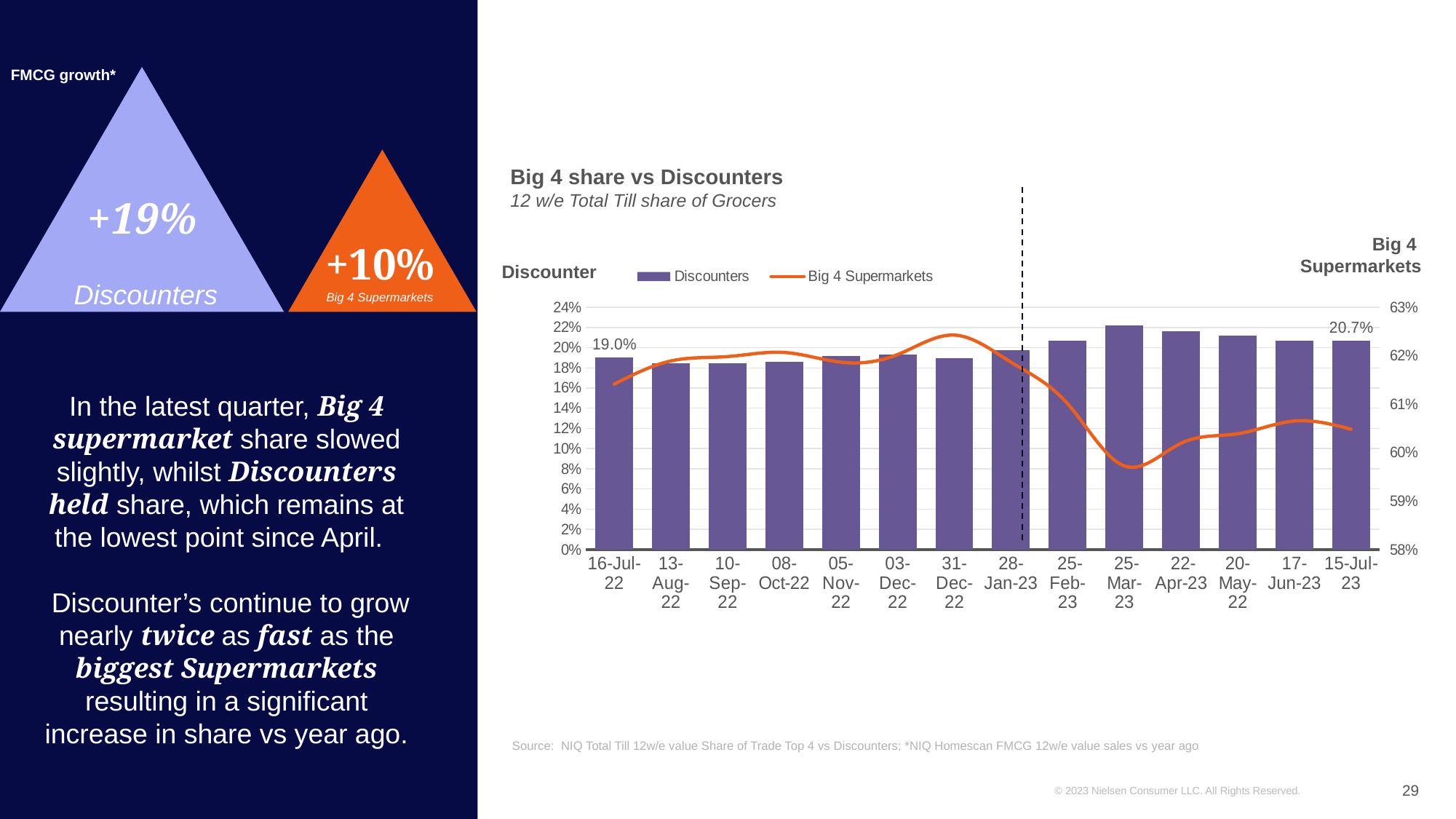
Does the Big 4 Supermarkets line rise or fall between 28-Jan-23 and 25-Mar-23? Fall Which is larger, the Discounters value for 16-Jul-22 or for 15-Jul-23? 15-Jul-23 Is the Big 4 Supermarkets value for 31-Dec-22 greater or less than 62%? greater What is the Discounters value for 16-Jul-22? 19.0% Which period has the highest Discounters bar? 25-Mar-23 What is the Discounters value for 15-Jul-23? 20.7% How many time periods are shown on the x axis? 14 Which series is plotted as a line? Big 4 Supermarkets What is the difference between the Discounters values for 15-Jul-23 and 16-Jul-22? 1.7 percentage points Is the Discounters value for 25-Mar-23 greater or less than 20%? greater What kind of chart is shown? Combined bar and line chart How many series does the legend list? 2